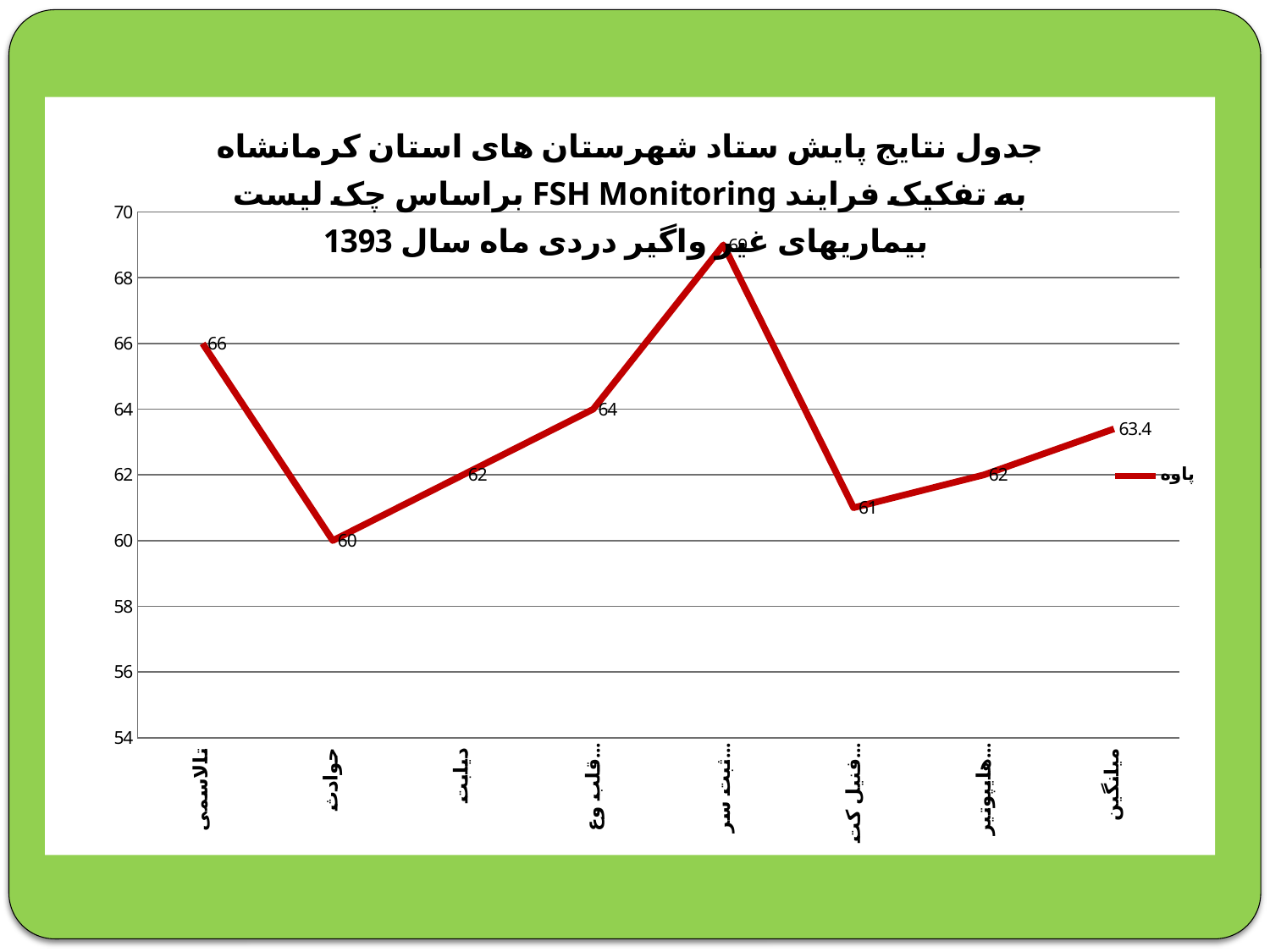
What is the value for تالاسمی? 66 What type of chart is shown on the slide? line chart Is the value for the fifth category from the left (the peak of the line) greater or less than 68? greater What is the value for میانگین? 63.4 What is the value for حوادث? 60 Which category has the lowest value? حوادث Which is larger, the value for تالاسمی or the value for میانگین? تالاسمی What is the value for دیابت? 62 How many categories are plotted on the x axis? 8 How many series does the legend list? 1 What is the name of the series shown in the legend? پاوه What is the difference between the values for تالاسمی and حوادث? 6